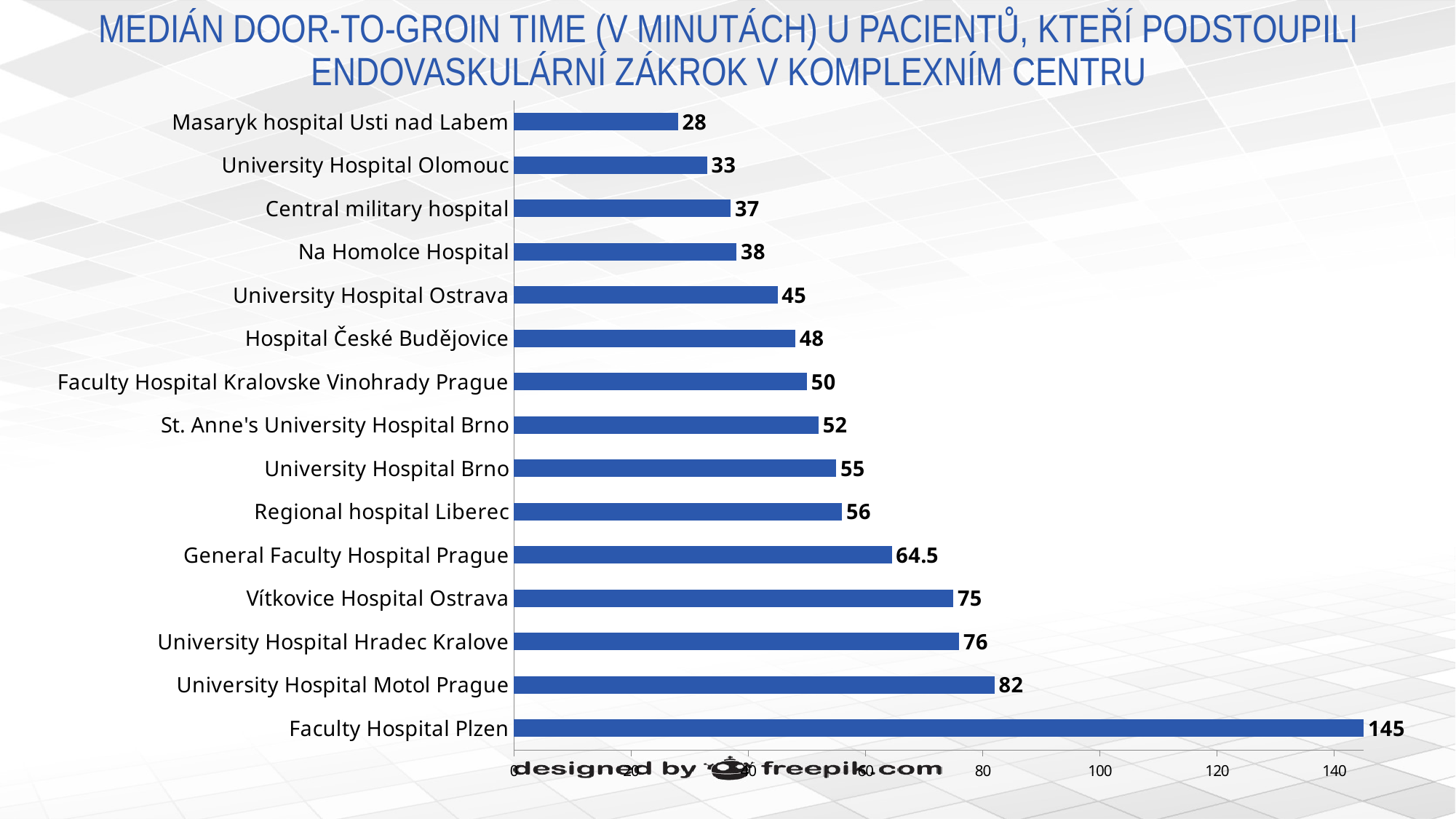
What is the value shown for University Hospital Ostrava? 45 What is the difference between the values for Faculty Hospital Plzen and Masaryk hospital Usti nad Labem? 117 What is the median door-to-groin time for Faculty Hospital Plzen? 145 How many hospitals are shown in the chart? 15 Which hospital has the highest median door-to-groin time? Faculty Hospital Plzen Which hospital has the lowest median door-to-groin time? Masaryk hospital Usti nad Labem What kind of chart is shown on the slide? bar chart Is the value for University Hospital Brno greater or less than 60? less What is the difference between the values for University Hospital Motol Prague and University Hospital Hradec Kralove? 6 What is the value shown for Hospital České Budějovice? 48 Which has a larger value, Vítkovice Hospital Ostrava or Regional hospital Liberec? Vítkovice Hospital Ostrava What is the value shown for General Faculty Hospital Prague? 64.5